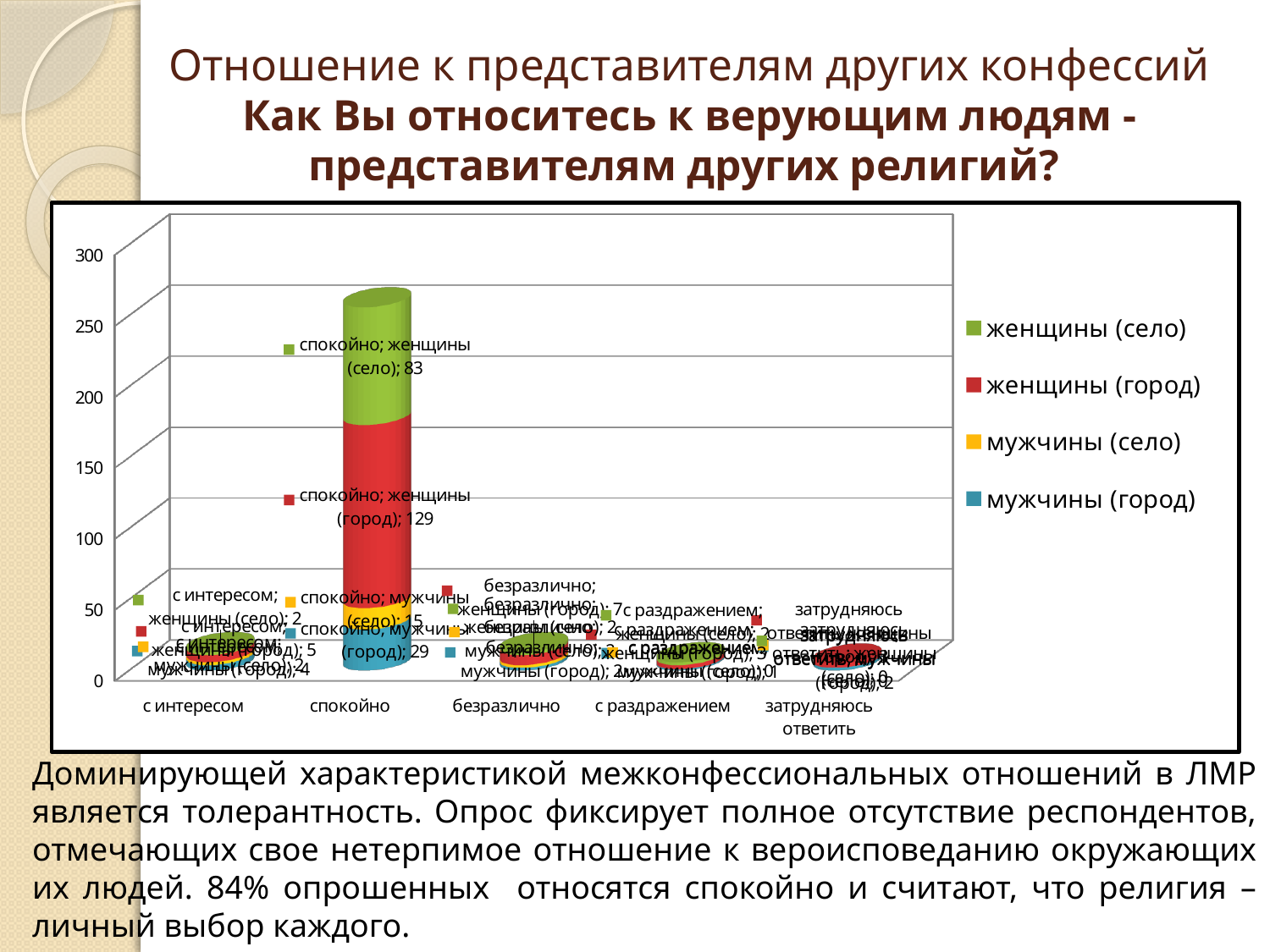
What kind of chart is shown on the slide? bar chart How many series does the legend list? 4 What is the value for мужчины (село) in the category спокойно? 15 What is the value for мужчины (город) in the category спокойно? 29 What is the total of the stacked bar for спокойно? 256 In the category спокойно, which is larger: женщины (город) or мужчины (город)? женщины (город) What is the value for женщины (город) in the category спокойно? 129 In the category спокойно, what is the difference between женщины (город) and женщины (село)? 46 Is the total height of the stacked bar for спокойно greater or less than 200? greater What is the value for женщины (село) in the category спокойно? 83 Which category has the tallest stacked bar? спокойно How many categories are shown along the x axis? 5